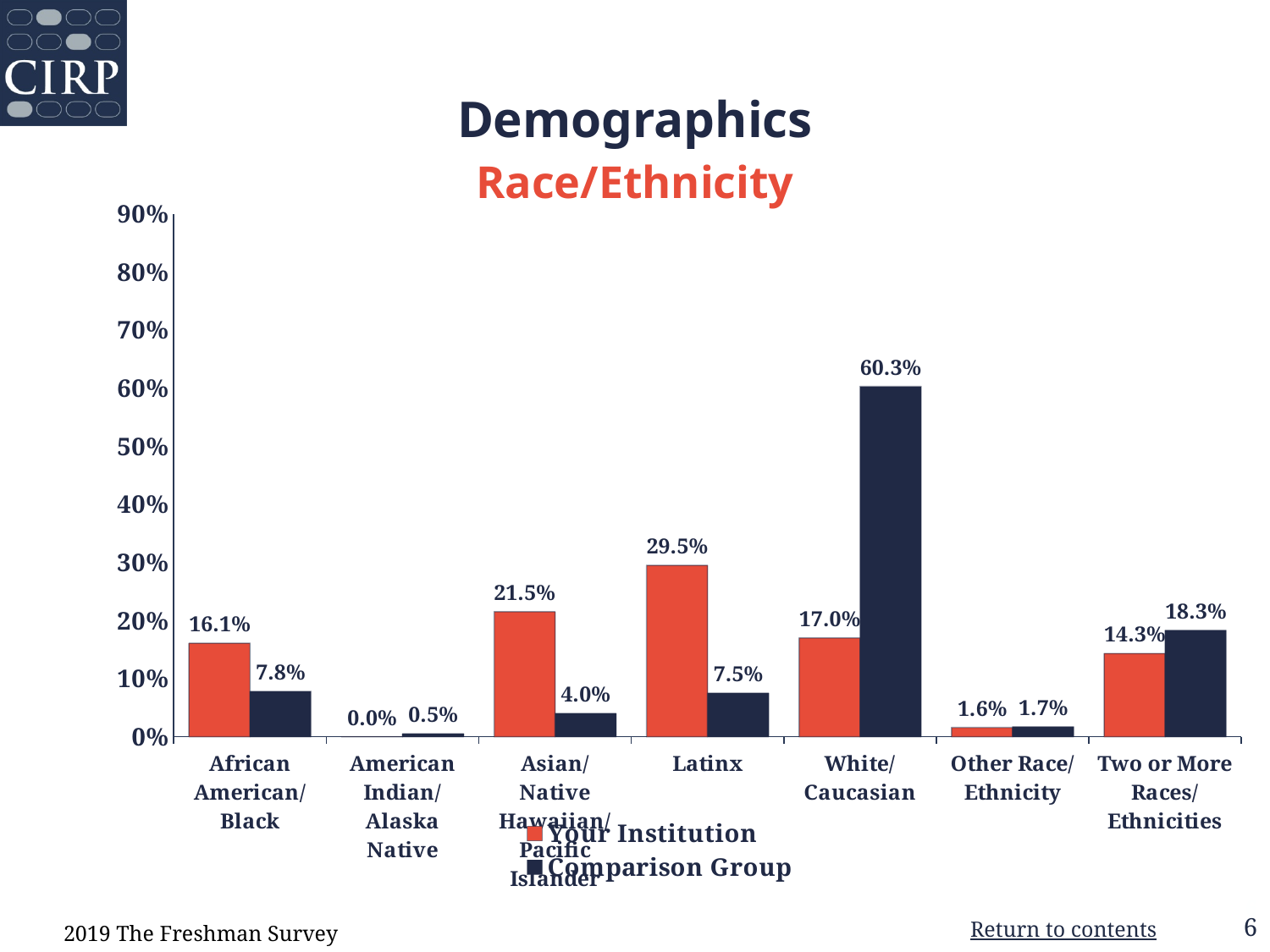
What kind of chart is shown on the slide? Bar chart What is the Comparison Group value for White/Caucasian? 60.3% What is the difference between the Comparison Group and Your Institution values for White/Caucasian? 43.3% What colour are the Comparison Group bars? Dark navy blue Which category has the lowest Comparison Group value? American Indian/Alaska Native Which is larger for Asian/Native Hawaiian/Pacific Islander: Your Institution or Comparison Group? Your Institution How many race/ethnicity categories are shown on the x axis? 7 How many series does the legend list? 2 What is the Comparison Group value for Two or More Races/Ethnicities? 18.3% What is the Your Institution value for African American/Black? 16.1% What is the Your Institution value for Latinx? 29.5% Which category has the highest Your Institution value? Latinx